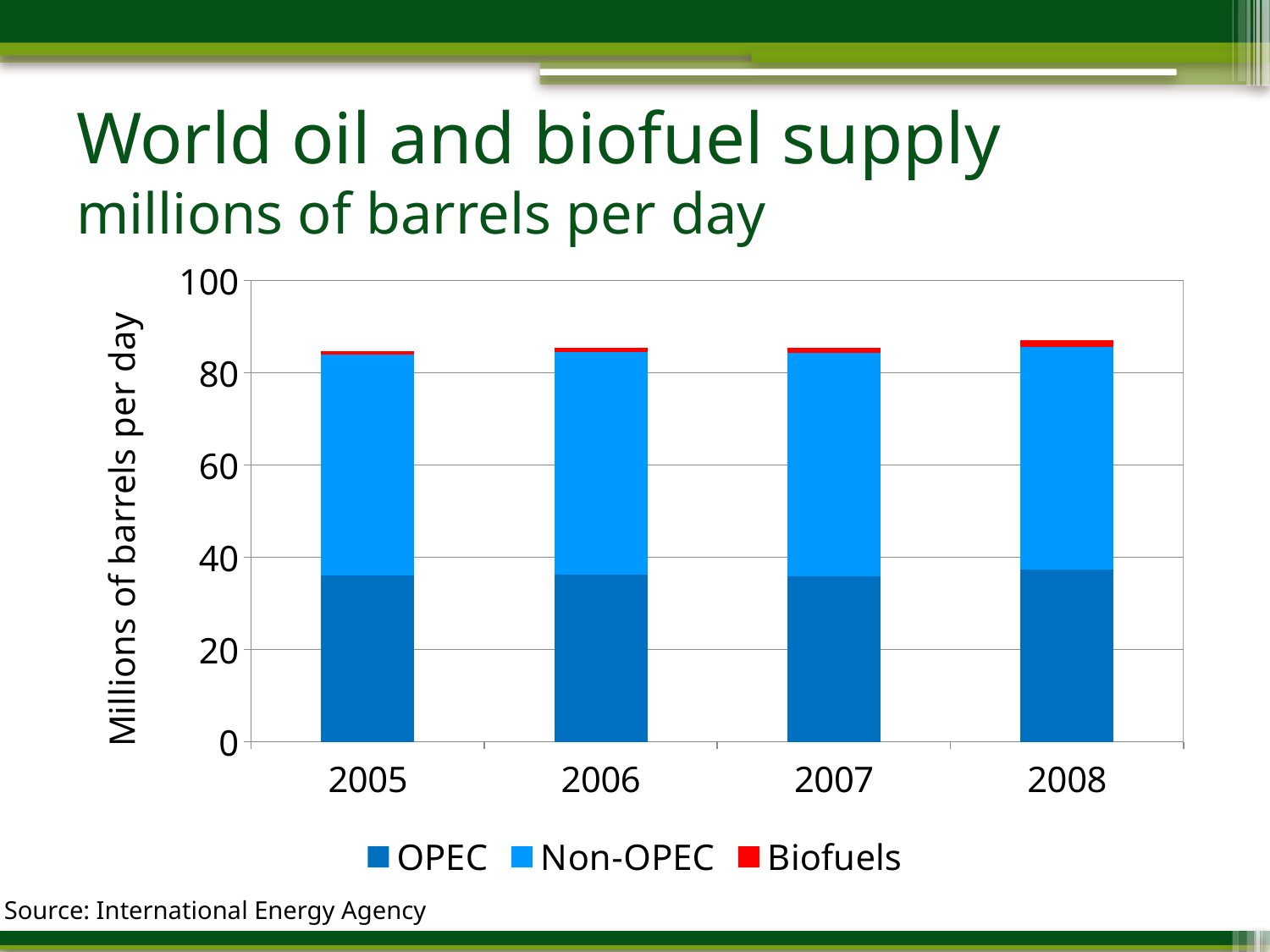
Which year has the tallest total stacked bar? 2008 Is the OPEC value for 2008 greater or less than 20? greater Is the total stacked bar for 2005 greater or less than 100? less Is the total stacked bar for 2008 greater or less than 80? greater Which series has the smallest segment in every year? Biofuels What kind of chart is shown on the slide? stacked bar chart Which series are listed in the legend? OPEC, Non-OPEC, Biofuels How many series does the legend list? 3 In 2006, which is larger, the OPEC segment or the Non-OPEC segment? Non-OPEC What is the label of the vertical axis? Millions of barrels per day How many years are shown on the x axis? 4